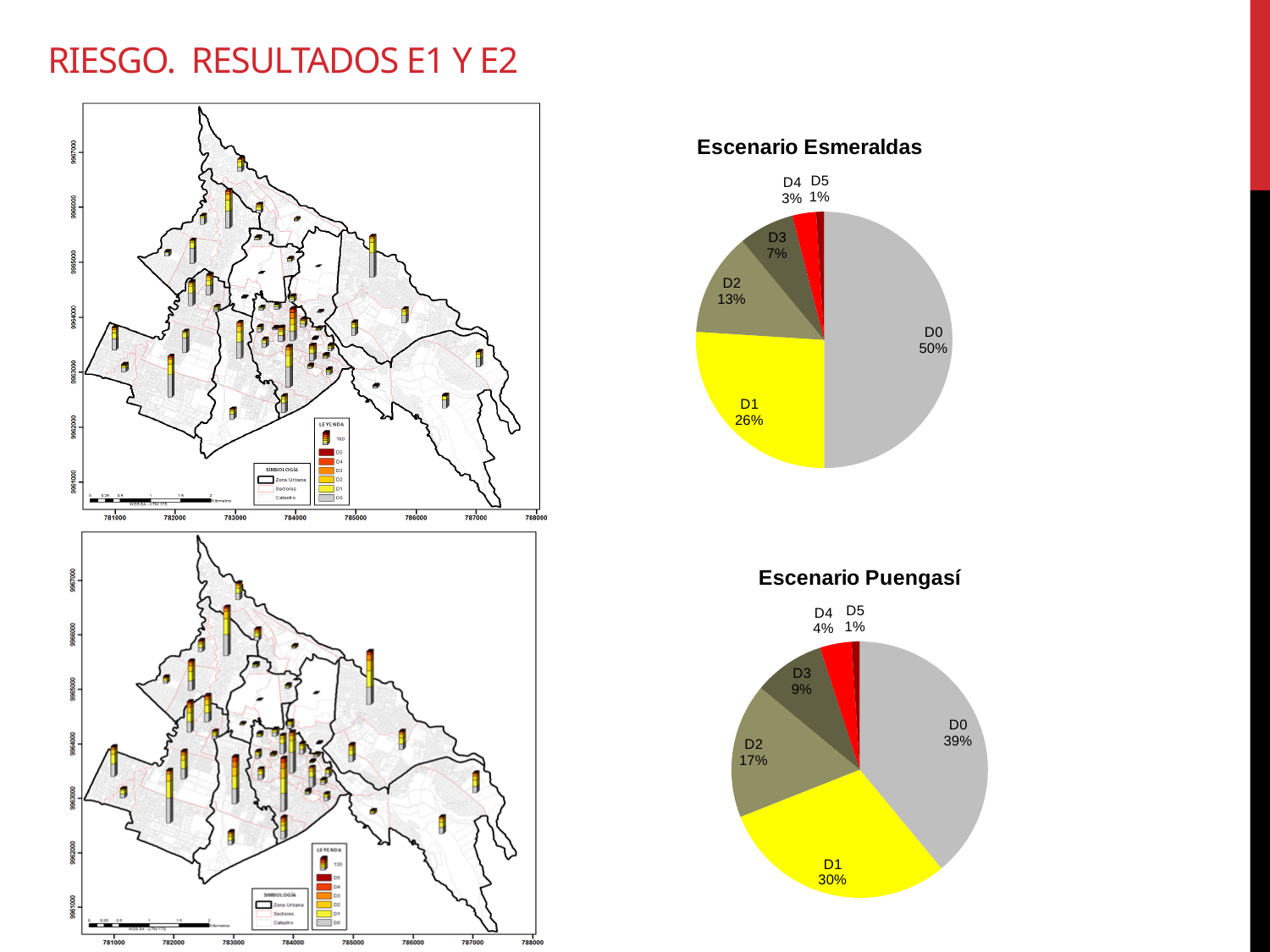
In the Escenario Puengasí pie chart, what colour is the D1 slice? Yellow In the Escenario Esmeraldas pie chart, what share does D0 have? 50% In the Escenario Puengasí pie chart, which category has the smallest share? D5 Which is larger: the share of D2 in the Escenario Esmeraldas pie chart or the share of D2 in the Escenario Puengasí pie chart? Escenario Puengasí In the Escenario Esmeraldas pie chart, which category has the largest share? D0 In the Escenario Puengasí pie chart, what share does D1 have? 30% In the Escenario Puengasí pie chart, what is the difference between the shares of D0 and D1? 9% In the Escenario Esmeraldas pie chart, what is the difference between the shares of D1 and D2? 13% In the Escenario Esmeraldas pie chart, what share does D3 have? 7% In the Escenario Puengasí pie chart, what share does D4 have? 4% How many slices does the Escenario Puengasí pie chart have? 6 What kind of chart is Escenario Esmeraldas? Pie chart